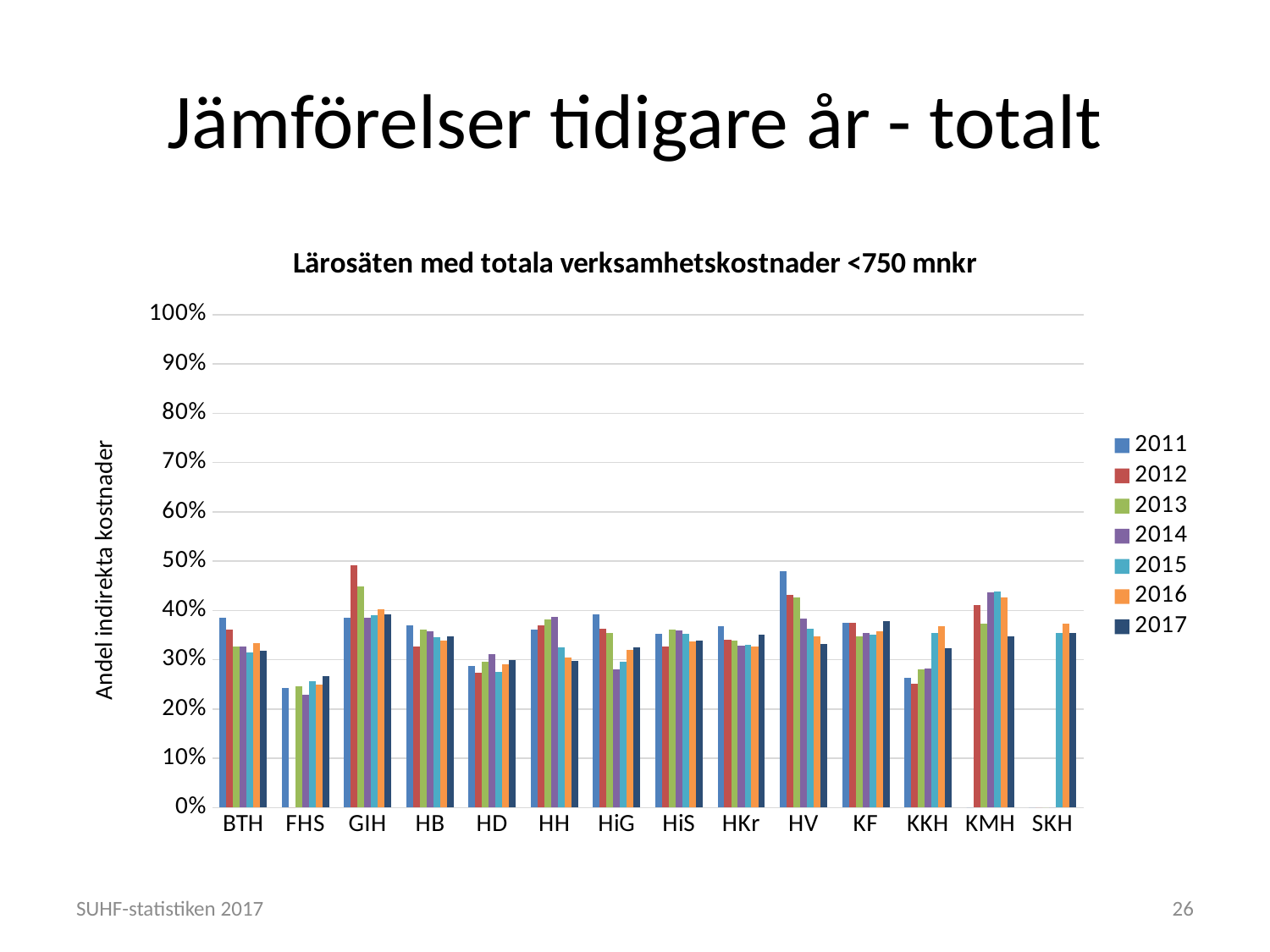
Is the 2012 value for GIH greater or less than 40%? greater Which institution has the highest 2012 value? GIH How many categories (institutions) are shown on the x axis? 14 For HV, which is larger: the 2011 value or the 2017 value? 2011 Is the 2012 value for KKH greater or less than 30%? less What is the title of the chart? Lärosäten med totala verksamhetskostnader <750 mnkr How many series does the legend list? 7 Which institution has the highest 2014 value? KMH What is the label of the vertical axis? Andel indirekta kostnader What type of chart is shown on the slide? Bar chart Is the 2011 value for FHS greater or less than 30%? less